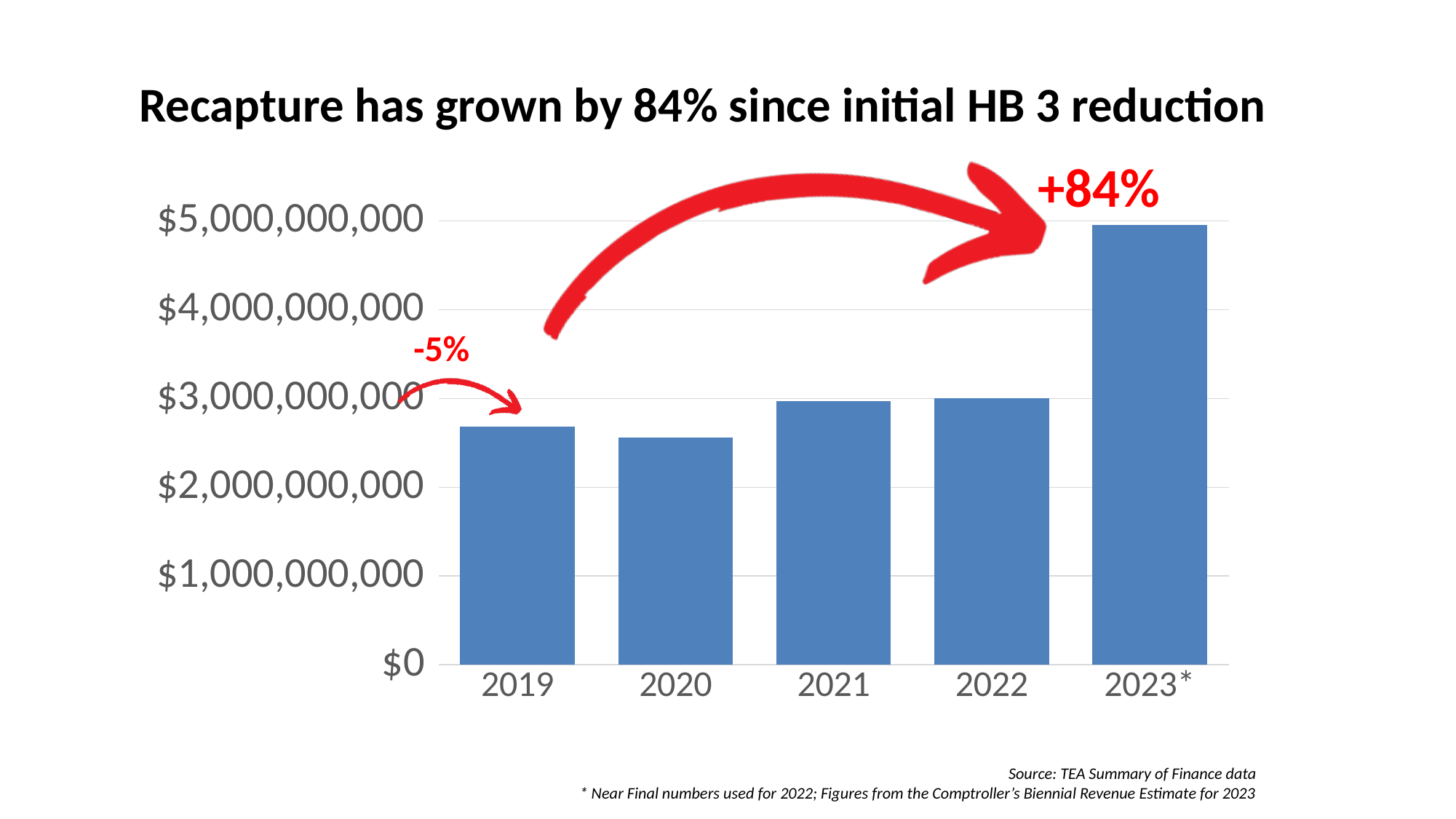
How many years are shown on the x axis of the chart? 5 Is the value for 2020 greater or less than $3,000,000,000? less What kind of chart is shown on the slide? bar chart From 2020 to 2023*, do the bar values rise or fall? rise Which is larger, the value for 2022 or the value for 2023*? 2023* Which is larger, the value for 2019 or the value for 2020? 2019 Which year has the lowest bar in the chart? 2020 Which year has the highest bar in the chart? 2023* Is the value for 2023* greater or less than $4,000,000,000? greater What percentage change is annotated in red above the 2023* bar? +84% Is the value for 2019 greater or less than $2,000,000,000? greater